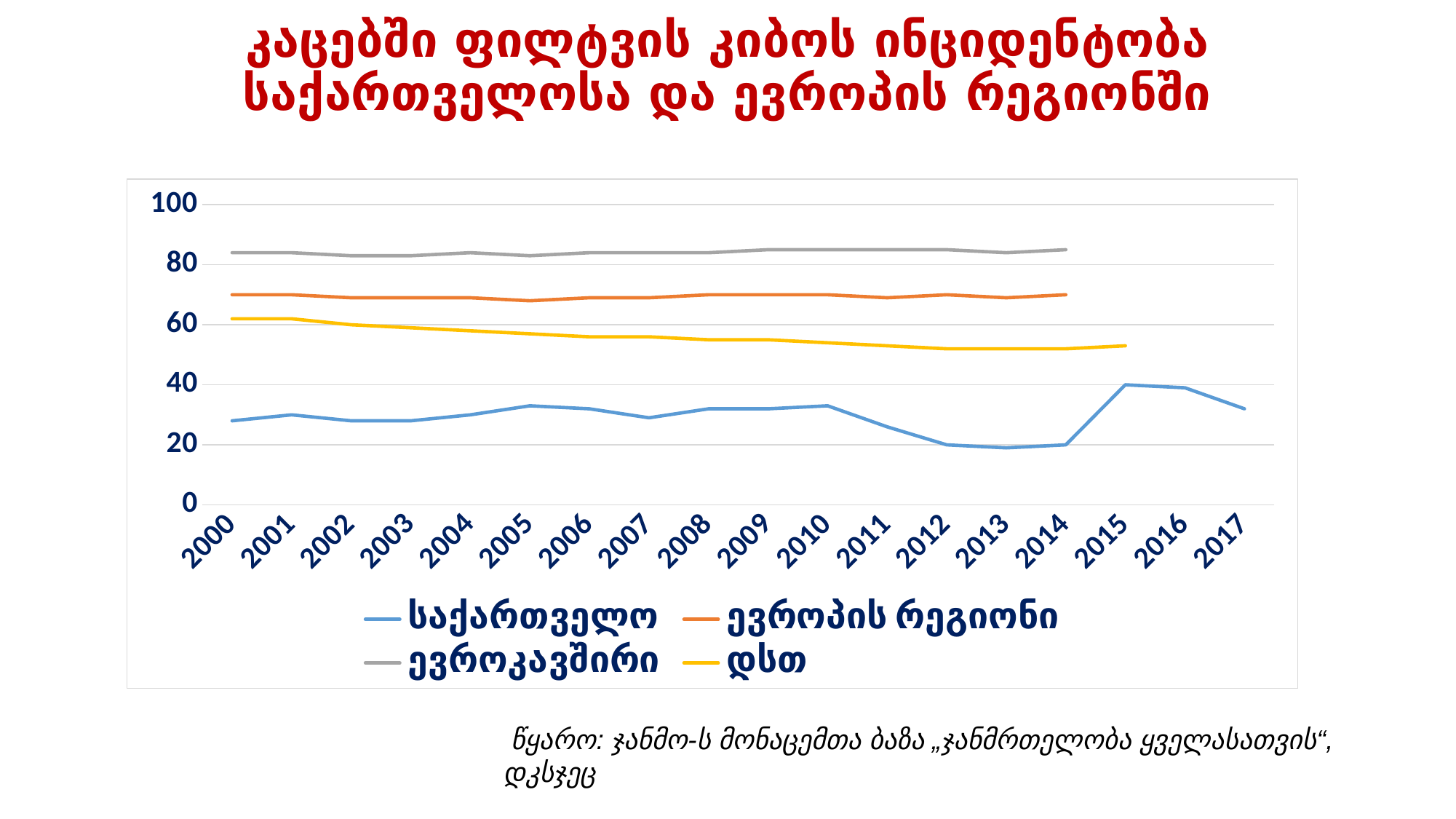
Which series has the lowest values across the chart? საქართველო Which series has the highest values across the chart? ევროკავშირი Is the value for საქართველო in 2000 greater or less than 40? less How many years are shown along the x axis? 18 What kind of chart is shown on the slide? line chart Which is larger in 2010, the value for ევროკავშირი or the value for საქართველო? ევროკავშირი Is the value for დსთ in 2014 greater or less than 60? less Is the value for ევროკავშირი in 2000 greater or less than 80? greater What colour is the line for საქართველო? blue Does the დსთ line rise or fall from 2000 to 2014? fall How many series does the legend list? 4